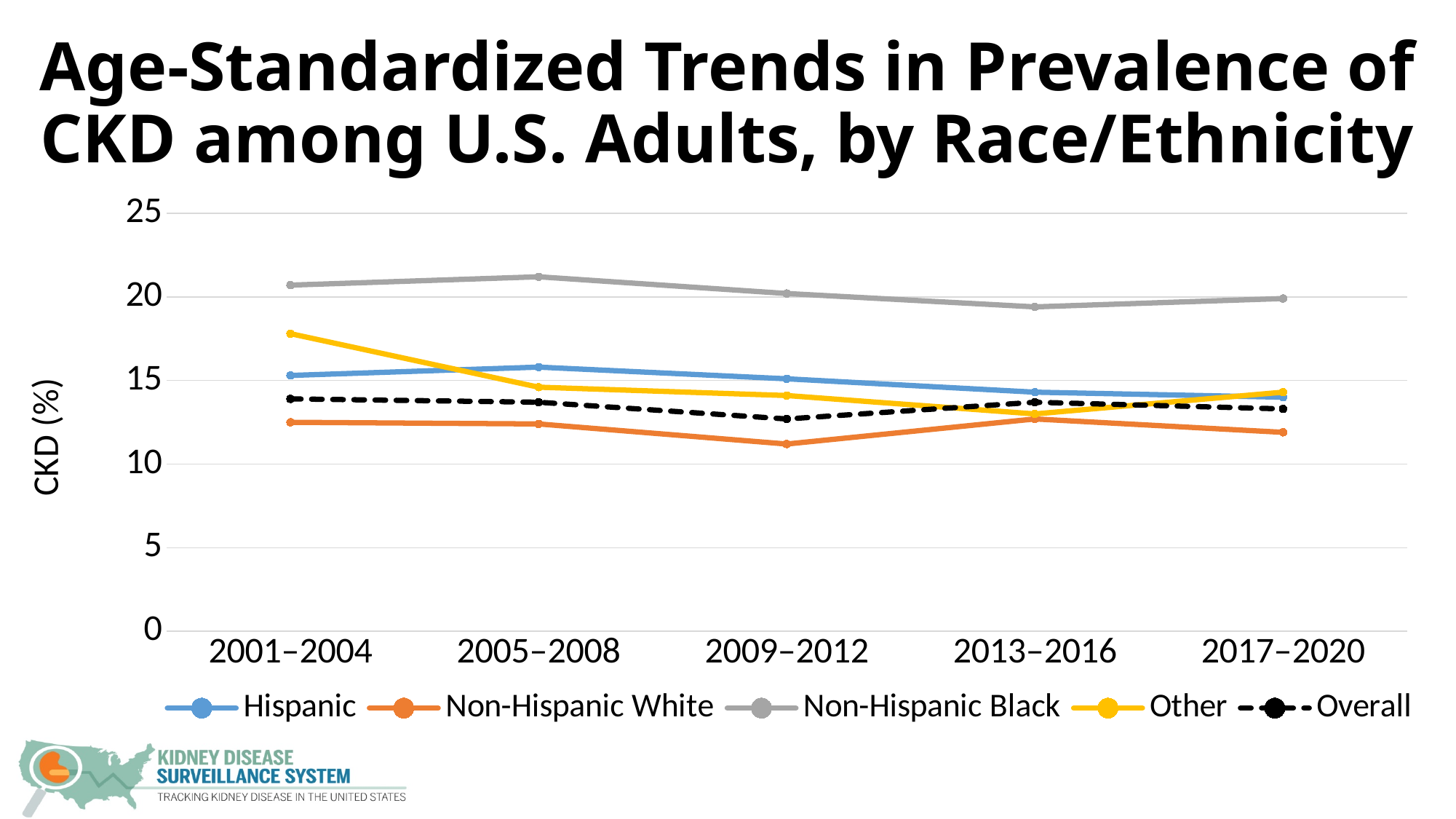
Which series is drawn with a dashed line? Overall Is the value for Non-Hispanic White in 2009–2012 greater or less than 15? less Is the value for Non-Hispanic Black in 2005–2008 greater or less than 20? greater Is the value for Other in 2001–2004 greater or less than 15? greater How many series does the legend list? 5 How many time periods are shown on the x axis? 5 In 2001–2004, which is larger: the value for Hispanic or the value for Other? Other What kind of chart is shown on the slide? line chart In 2017–2020, which is larger: the value for Non-Hispanic Black or the value for Hispanic? Non-Hispanic Black Which race/ethnicity group has the lowest CKD prevalence in 2009–2012? Non-Hispanic White Does the Other series rise or fall from 2001–2004 to 2013–2016? fall Which race/ethnicity group has the highest CKD prevalence in 2001–2004? Non-Hispanic Black